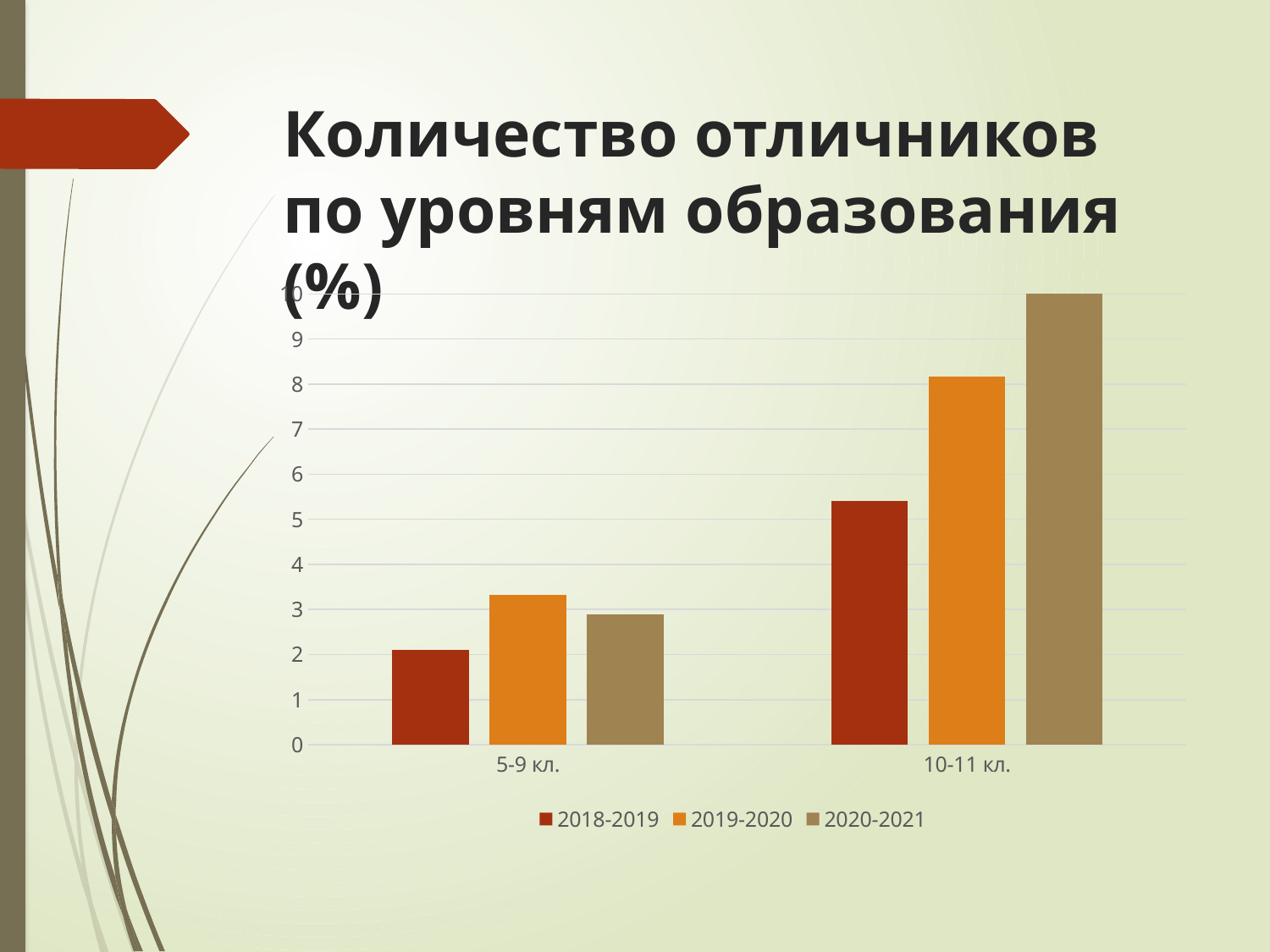
Which is larger: the 2020-2021 value for 5-9 кл. or the 2020-2021 value for 10-11 кл.? 10-11 кл. Which series has the highest value for 5-9 кл.? 2019-2020 How many categories are shown on the x axis? 2 Which series is shown in orange in the legend? 2019-2020 Is the value for 2019-2020 in 10-11 кл. greater or less than 8? greater Is the value for 2018-2019 in 10-11 кл. greater or less than 5? greater Which series has the highest value for 10-11 кл.? 2020-2021 What kind of chart is shown on the slide? bar chart What is the title of the chart? Количество отличников по уровням образования (%) How many series does the legend list? 3 Which series has the lowest value for 5-9 кл.? 2018-2019 Is the value for 2018-2019 in 5-9 кл. greater or less than 3? less